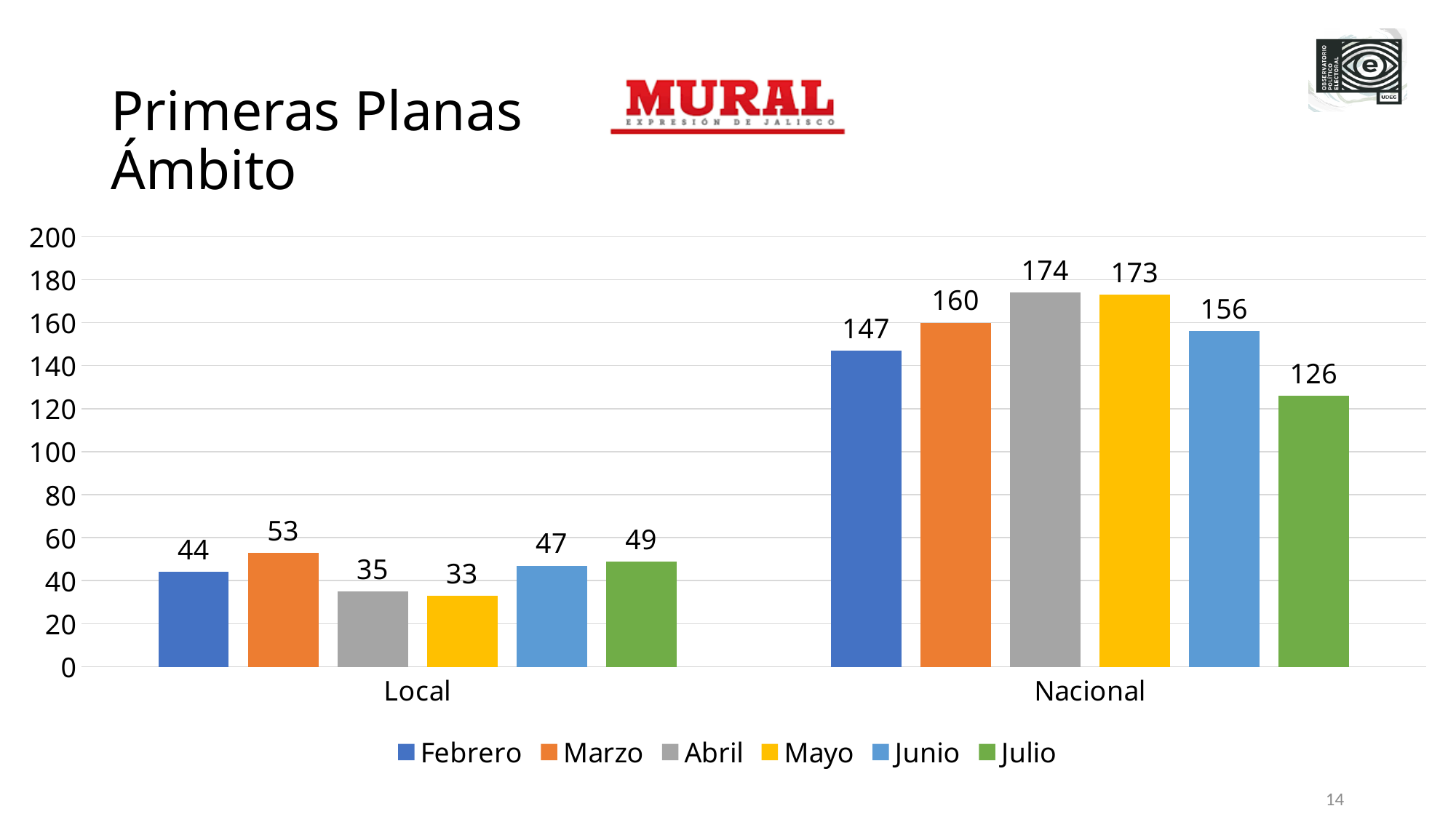
How many categories are shown on the x axis? 2 Which is larger in the Local category, Junio or Julio? Julio Is the value for Junio in the Nacional category greater or less than 140? greater What colour represents Mayo in the chart? Yellow What kind of chart is shown on the slide? Bar chart What is the value for Abril in the Nacional category? 174 Which month has the highest value in the Nacional category? Abril Which month has the lowest value in the Local category? Mayo What is the value for Marzo in the Local category? 53 What is the value for Julio in the Nacional category? 126 What is the difference between the Nacional values for Marzo and Febrero? 13 How many series does the legend list? 6